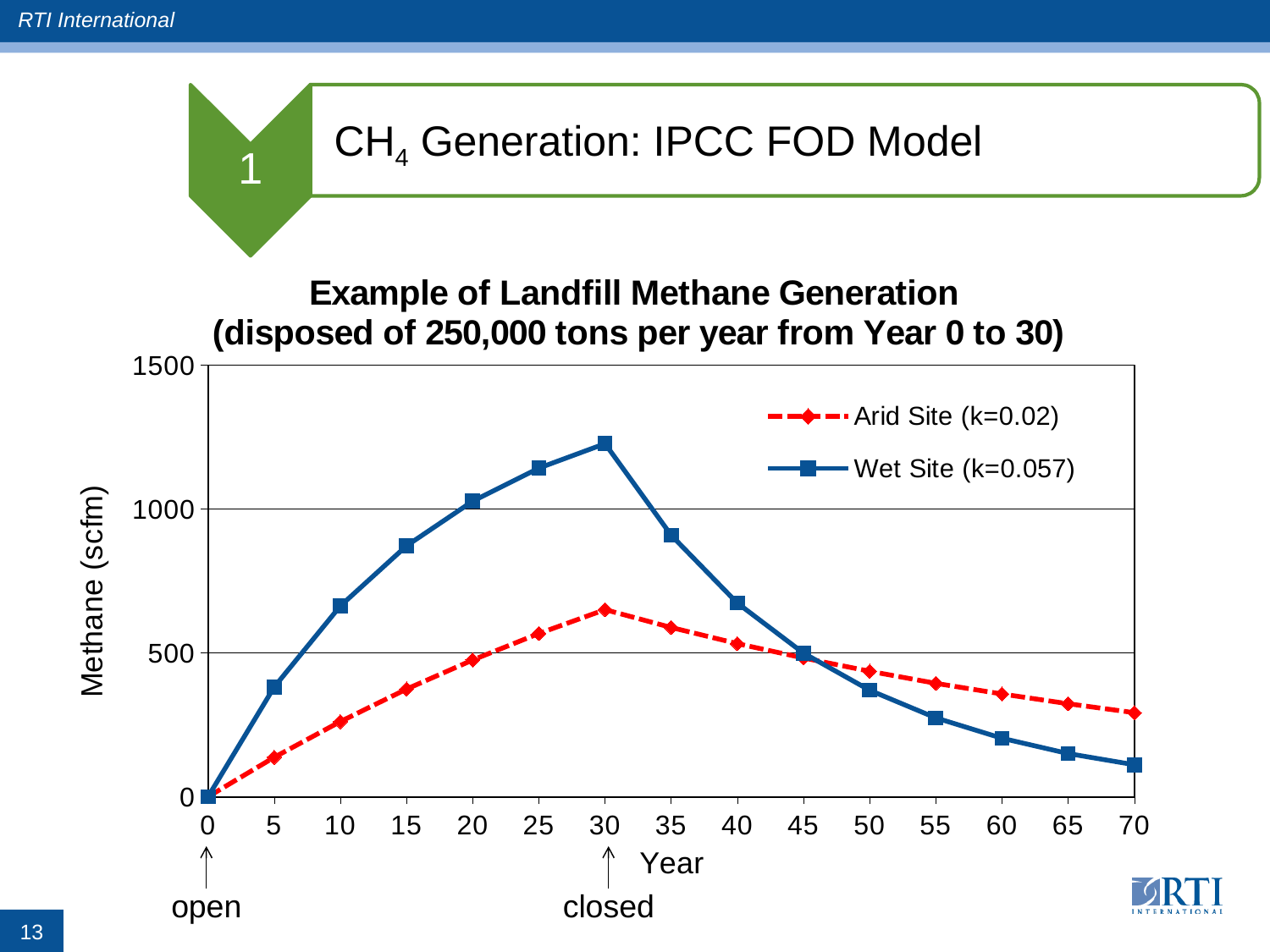
At which year does the Arid Site (k=0.02) series reach its highest value? 30 What kind of chart is shown on the slide? Line chart Is the value for the Wet Site (k=0.057) at Year 30 greater or less than 1000? greater What are the two series named in the legend? Arid Site (k=0.02) and Wet Site (k=0.057) How many series does the legend list? 2 Is the value for the Arid Site (k=0.02) at Year 70 greater or less than 500? less How many data points are plotted for the Wet Site (k=0.057) series? 15 At which year does the Wet Site (k=0.057) series reach its highest value? 30 What is the label of the y axis? Methane (scfm) What is the methane value for the Wet Site (k=0.057) at Year 0? 0 At Year 60, which series has the larger value, Arid Site (k=0.02) or Wet Site (k=0.057)? Arid Site (k=0.02) Does the Wet Site (k=0.057) series rise or fall between Year 30 and Year 70? Fall